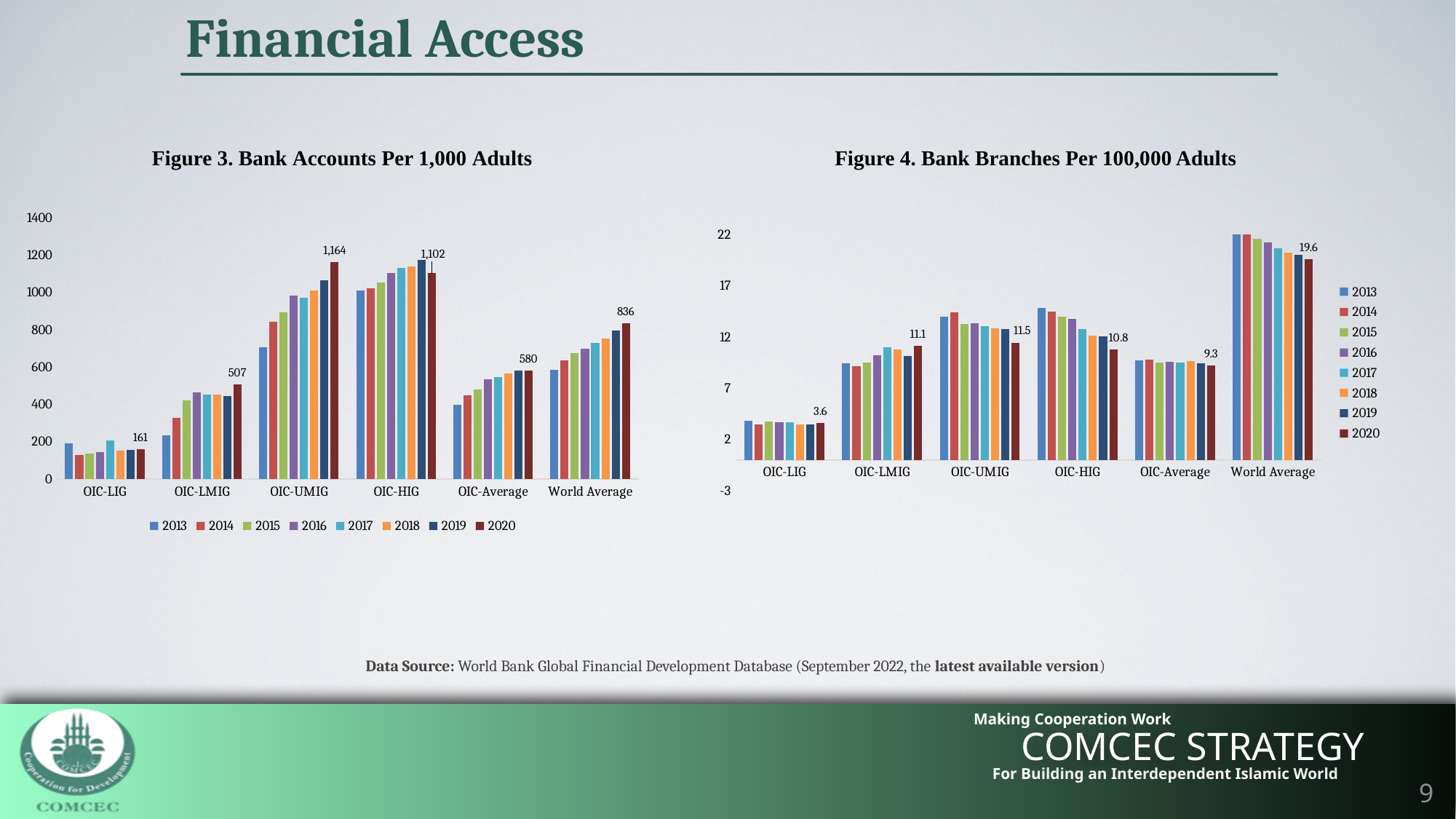
What kind of chart is Figure 4 (Bank Branches Per 100,000 Adults)? bar chart In Figure 3 (Bank Accounts Per 1,000 Adults), what is the difference between the 2020 values for World Average and OIC-Average? 256 In Figure 4 (Bank Branches Per 100,000 Adults), what is the 2020 value for World Average? 19.6 In Figure 3 (Bank Accounts Per 1,000 Adults), which category has the highest 2020 value? OIC-UMIG In Figure 4 (Bank Branches Per 100,000 Adults), what is the difference between the 2020 values for OIC-UMIG and OIC-LMIG? 0.4 How many series does the legend of Figure 3 (Bank Accounts Per 1,000 Adults) list? 8 In Figure 3 (Bank Accounts Per 1,000 Adults), what is the 2020 value for OIC-UMIG? 1,164 How many categories are shown on the x axis of Figure 4 (Bank Branches Per 100,000 Adults)? 6 In Figure 4 (Bank Branches Per 100,000 Adults), which has the larger 2020 value, OIC-HIG or OIC-Average? OIC-HIG In Figure 4 (Bank Branches Per 100,000 Adults), which category has the lowest 2020 value? OIC-LIG In Figure 3 (Bank Accounts Per 1,000 Adults), what is the 2020 value for OIC-LIG? 161 In Figure 3 (Bank Accounts Per 1,000 Adults), is the 2013 value for OIC-HIG greater or less than 800? greater